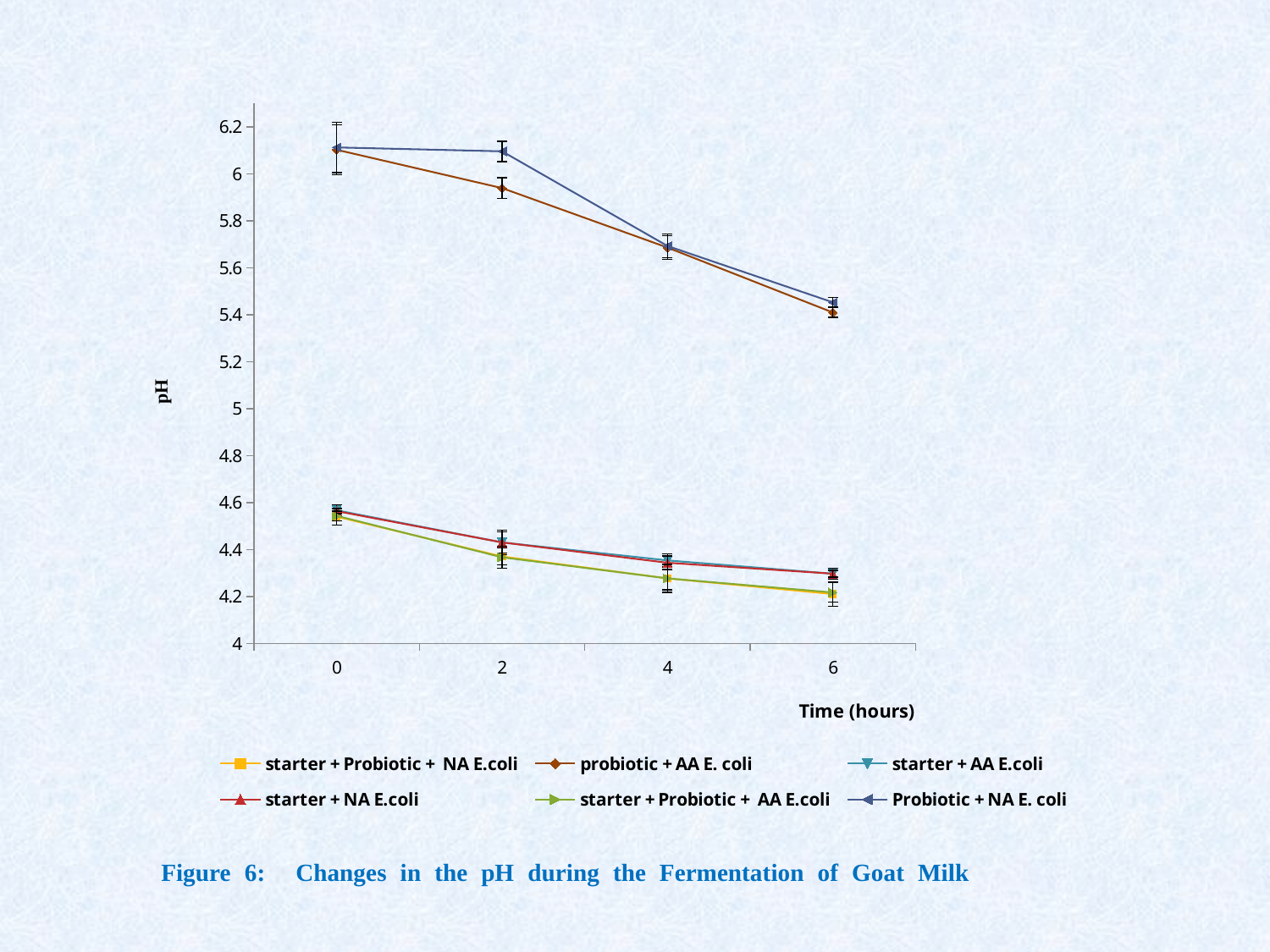
Is the pH for starter + Probiotic + AA E.coli at 6 hours greater or less than 4.4? less Do the pH values rise or fall as time increases from 0 to 6 hours? fall What is the caption of the figure on the slide? Figure 6: Changes in the pH during the Fermentation of Goat Milk What is the label of the x axis? Time (hours) At 0 hours, which has the higher pH: probiotic + AA E. coli or starter + NA E.coli? probiotic + AA E. coli How many time points are plotted along the x axis? 4 At 2 hours, which has the higher pH: Probiotic + NA E. coli or probiotic + AA E. coli? Probiotic + NA E. coli How many series does the legend list? 6 Is the pH for starter + NA E.coli at 0 hours greater or less than 4.4? greater What kind of chart is shown on the slide? line chart Is the pH for probiotic + AA E. coli at 6 hours greater or less than 5.6? less